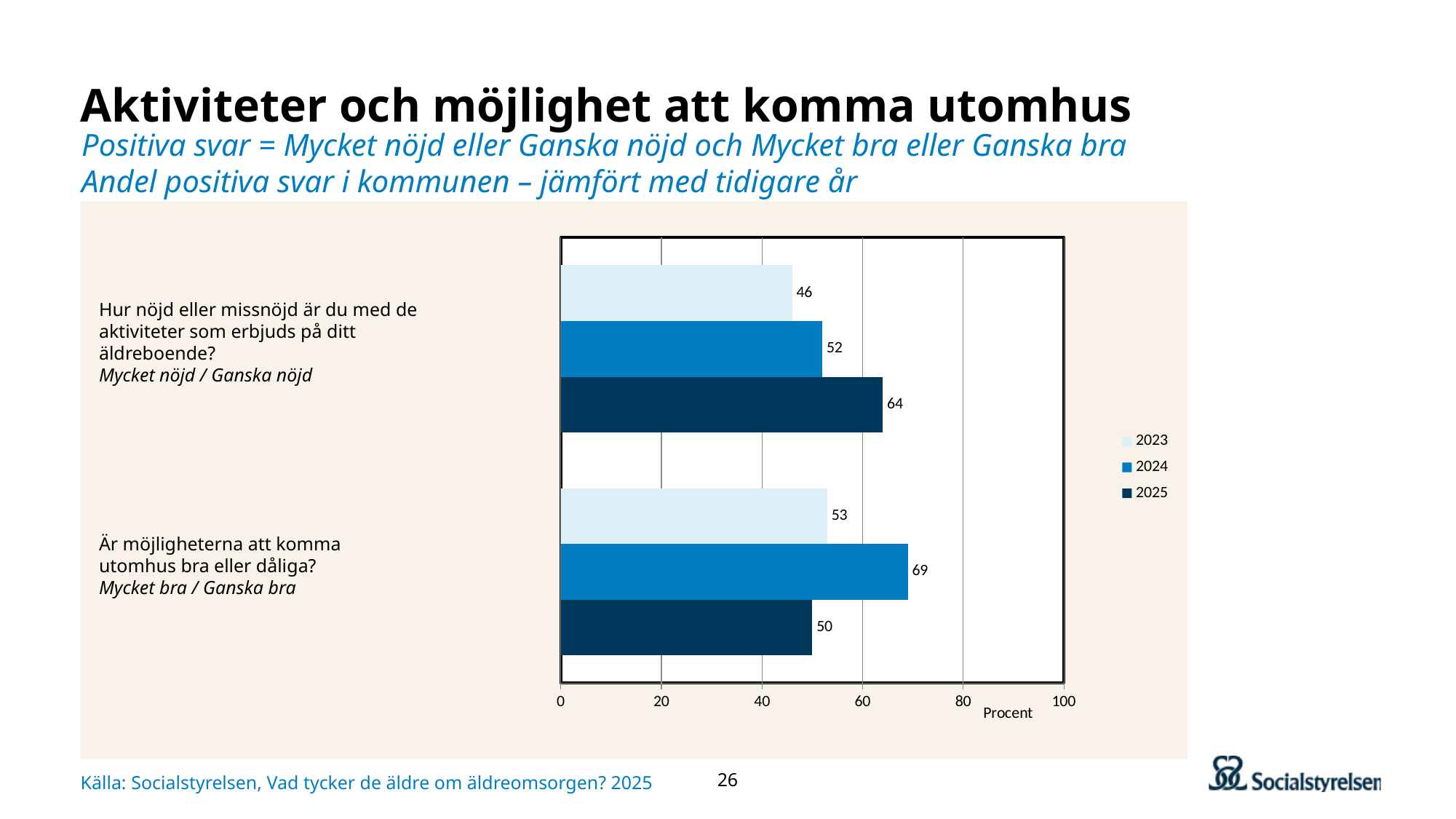
Which year has the highest value for the question about opportunities to get outdoors? 2024 What kind of chart is shown on the slide? Bar chart Do the values for the activities question rise or fall from 2023 to 2025? Rise Is the 2024 value for the outdoors question greater or less than 60? greater What is the 2025 value for the question about activities offered at the care home (Hur nöjd eller missnöjd är du med de aktiviteter som erbjuds på ditt äldreboende?)? 64 What is the 2023 value for the question about activities offered at the care home? 46 Which year has the lowest value for the question about activities offered at the care home? 2023 What unit is shown on the horizontal axis of the chart? Procent What is the difference between the 2025 and 2023 values for the question about activities offered at the care home? 18 What is the 2024 value for the question about opportunities to get outdoors (Är möjligheterna att komma utomhus bra eller dåliga?)? 69 Which is larger: the 2025 value for the activities question or the 2025 value for the outdoors question? The 2025 value for the activities question (64) How many series does the legend list? 3